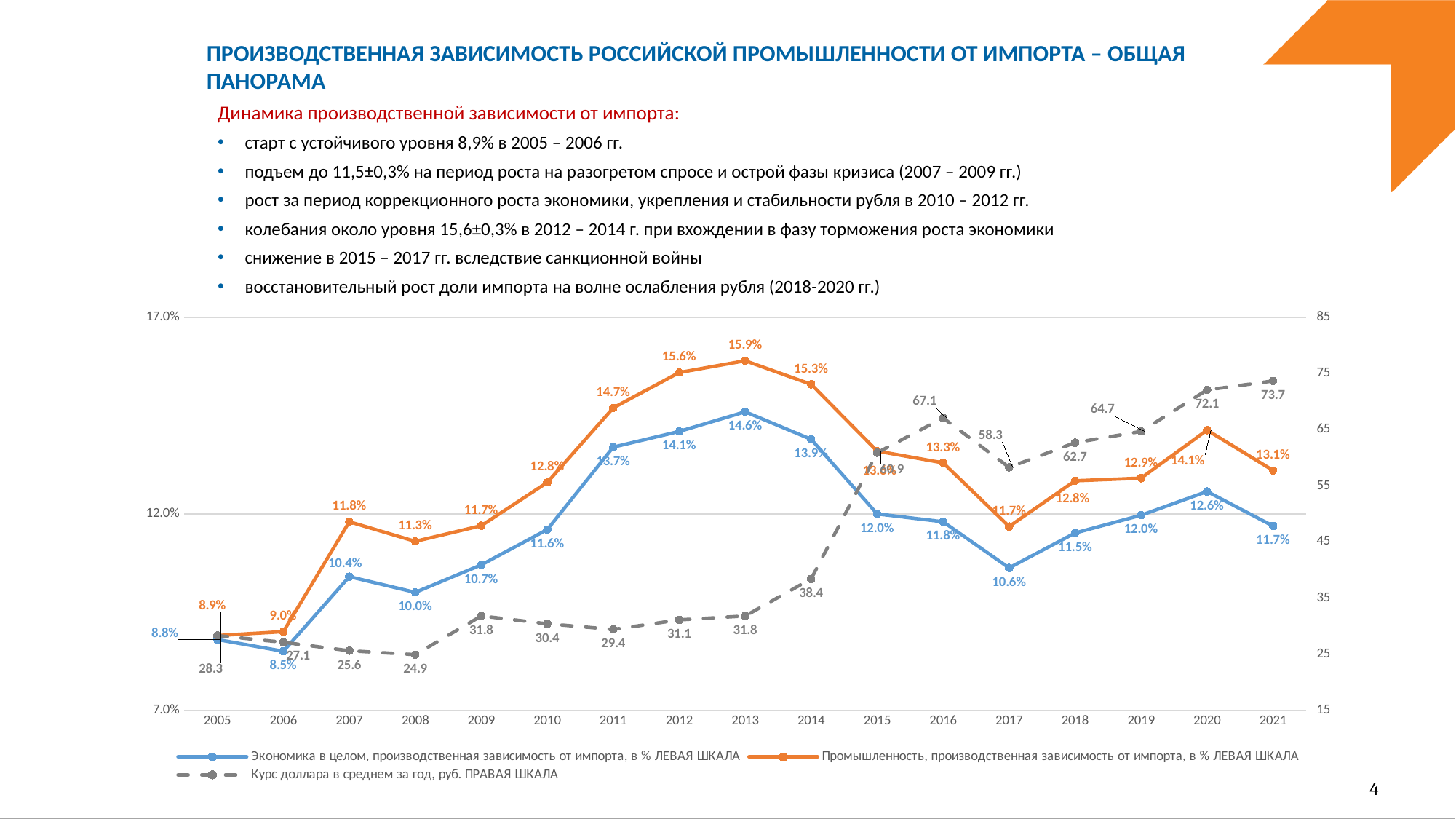
Which is larger in 2020: the 'Промышленность' value or the 'Экономика в целом' value? Промышленность Which series is drawn with a dashed grey line? Курс доллара в среднем за год, руб. ПРАВАЯ ШКАЛА What is the value of the 'Курс доллара' series in 2021? 73.7 What type of chart is shown on the slide? line chart Does the 'Курс доллара' series rise or fall from 2017 to 2021? rise In which year does the 'Экономика в целом' series reach its highest value? 2013 In which year is the 'Курс доллара' series at its lowest? 2008 How many series does the legend list? 3 What is the value of the 'Промышленность' series in 2013? 15.9% How many years are shown on the x axis? 17 What is the value of the 'Экономика в целом' series in 2017? 10.6% What is the difference between the 'Промышленность' and 'Экономика в целом' values in 2012? 1.5%